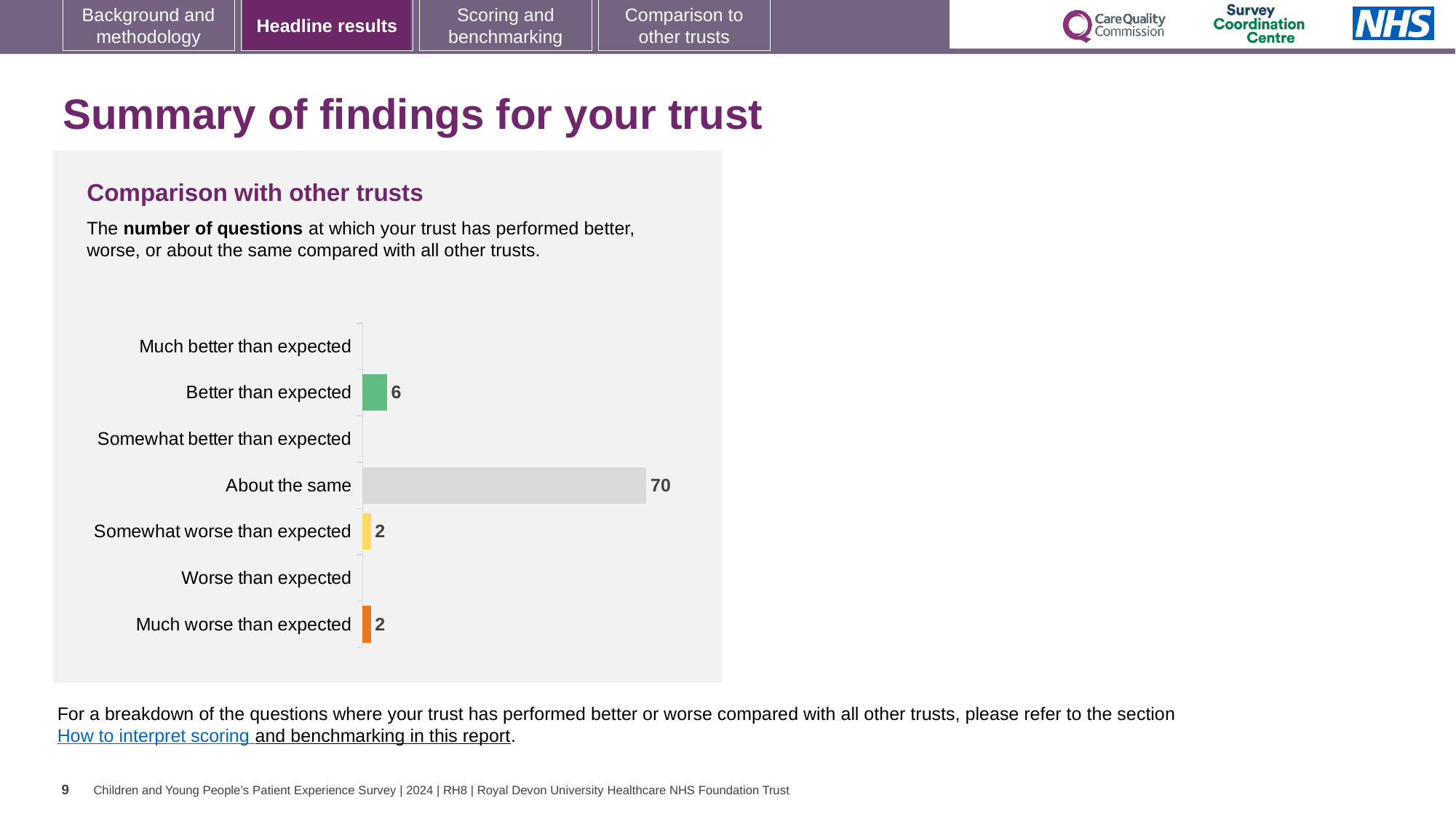
Which category has the highest number of questions? About the same How many categories are listed on the chart's axis? 7 What is the difference between the number of questions 'Better than expected' and 'Much worse than expected'? 4 What is the difference between the number of questions 'About the same' and 'Better than expected'? 64 How many questions are in the 'About the same' category? 70 What colour is the bar for 'Much worse than expected'? Orange How many questions are in the 'Much worse than expected' category? 2 How many questions are in the 'Better than expected' category? 6 What is the title of the chart? Comparison with other trusts What kind of chart is shown on the slide? Bar chart Which is larger: the number of questions 'Better than expected' or 'Somewhat worse than expected'? Better than expected How many questions are in the 'Somewhat worse than expected' category? 2